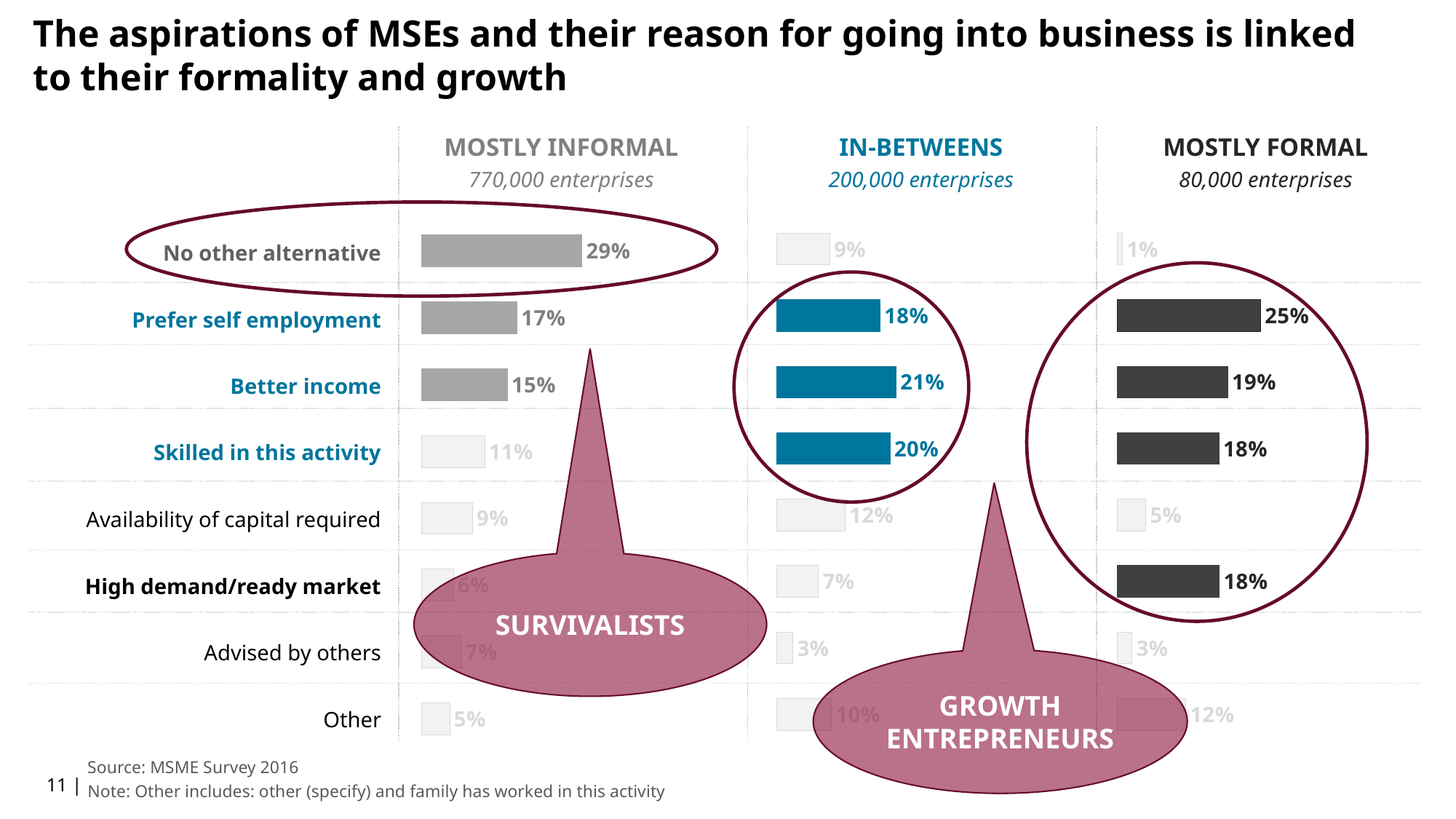
In the Mostly Informal chart, what is the value for No other alternative? 29% In the In-Betweens chart, what is the value for Better income? 21% How many categories are shown in each chart? 8 How many enterprises are in the In-Betweens group according to the chart heading? 200,000 enterprises In the Mostly Formal chart, which category has the lowest value? No other alternative In the Mostly Informal chart, which category has the highest value? No other alternative In the Mostly Formal chart, what is the value for Prefer self employment? 25% In the Mostly Formal chart, what is the value for High demand/ready market? 18% What is the difference between the Mostly Informal and Mostly Formal values for No other alternative? 28% In the In-Betweens chart, which category has the highest value? Better income In the In-Betweens chart, which is larger: Skilled in this activity or Availability of capital required? Skilled in this activity What kind of chart is used for the Mostly Formal group? Bar chart